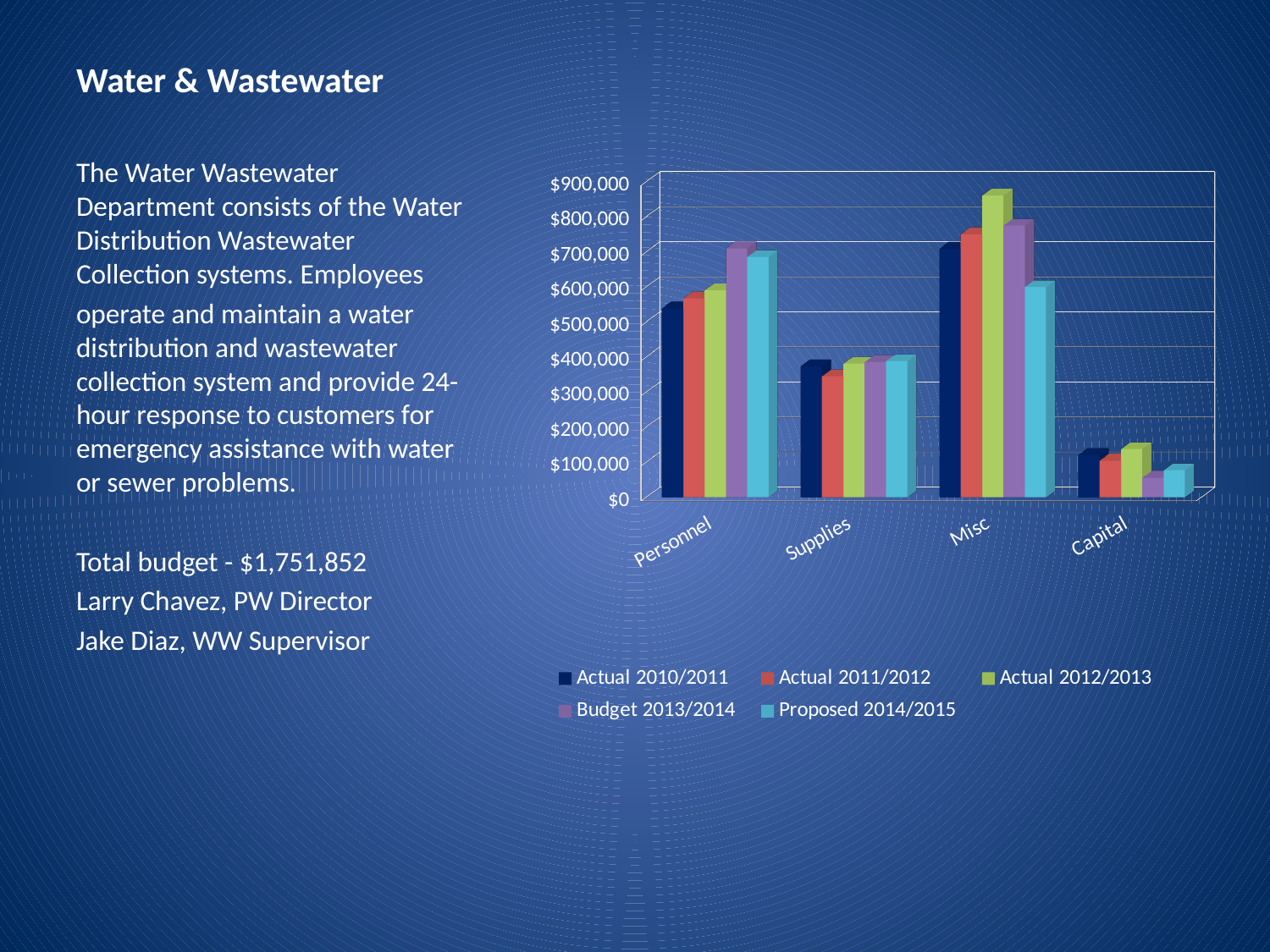
Is the value for Personnel in the Budget 2013/2014 series greater or less than $600,000? greater Is the value for Supplies in the Actual 2011/2012 series greater or less than $400,000? less Which category has the lowest values across all series in the chart? Capital Is the value for Capital in the Budget 2013/2014 series greater or less than $100,000? less Which series is shown in green in the chart's legend? Actual 2012/2013 For the Actual 2010/2011 series, which is larger: Personnel or Supplies? Personnel Which series has the highest value in the Misc category? Actual 2012/2013 What kind of chart is shown on the slide? Bar chart How many categories are shown on the x axis of the chart? 4 Which category has the highest value for the Actual 2012/2013 series? Misc How many series does the chart's legend list? 5